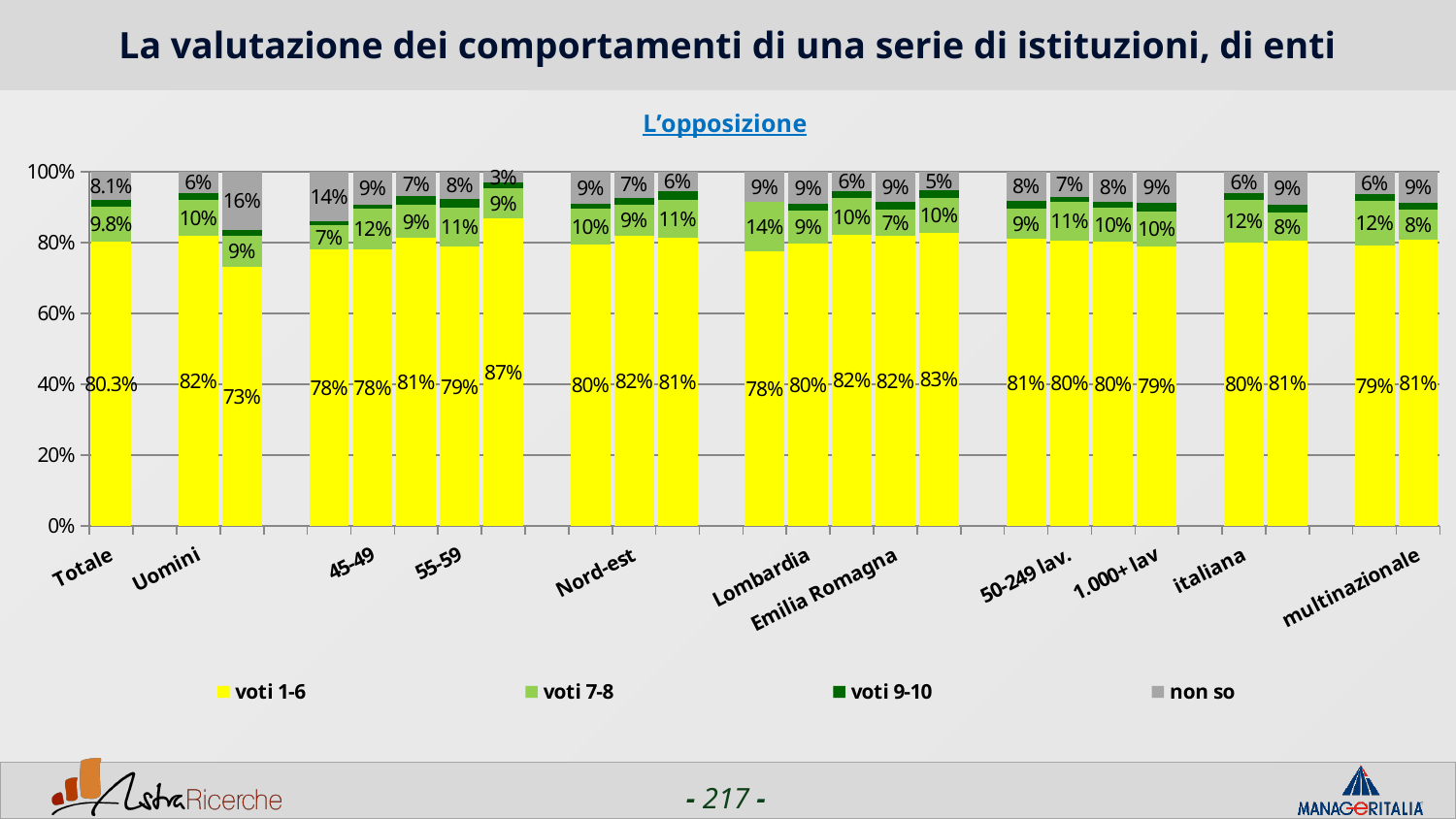
What is the lowest voti 1-6 value shown in the chart? 73% What are the legend entries of the chart? voti 1-6, voti 7-8, voti 9-10, non so What is the voti 1-6 value for Totale? 80.3% What is the non so value for Uomini? 6% What is the voti 1-6 value for Uomini? 82% Is the voti 1-6 value for Uomini greater or less than 60%? greater Which has a larger voti 1-6 value, Uomini or Totale? Uomini What kind of chart is shown on the slide? Stacked bar chart What is the highest voti 1-6 value shown in the chart? 87% What is the voti 7-8 value for Totale? 9.8% What is the subtitle of the chart? L'opposizione How many series does the legend list? 4